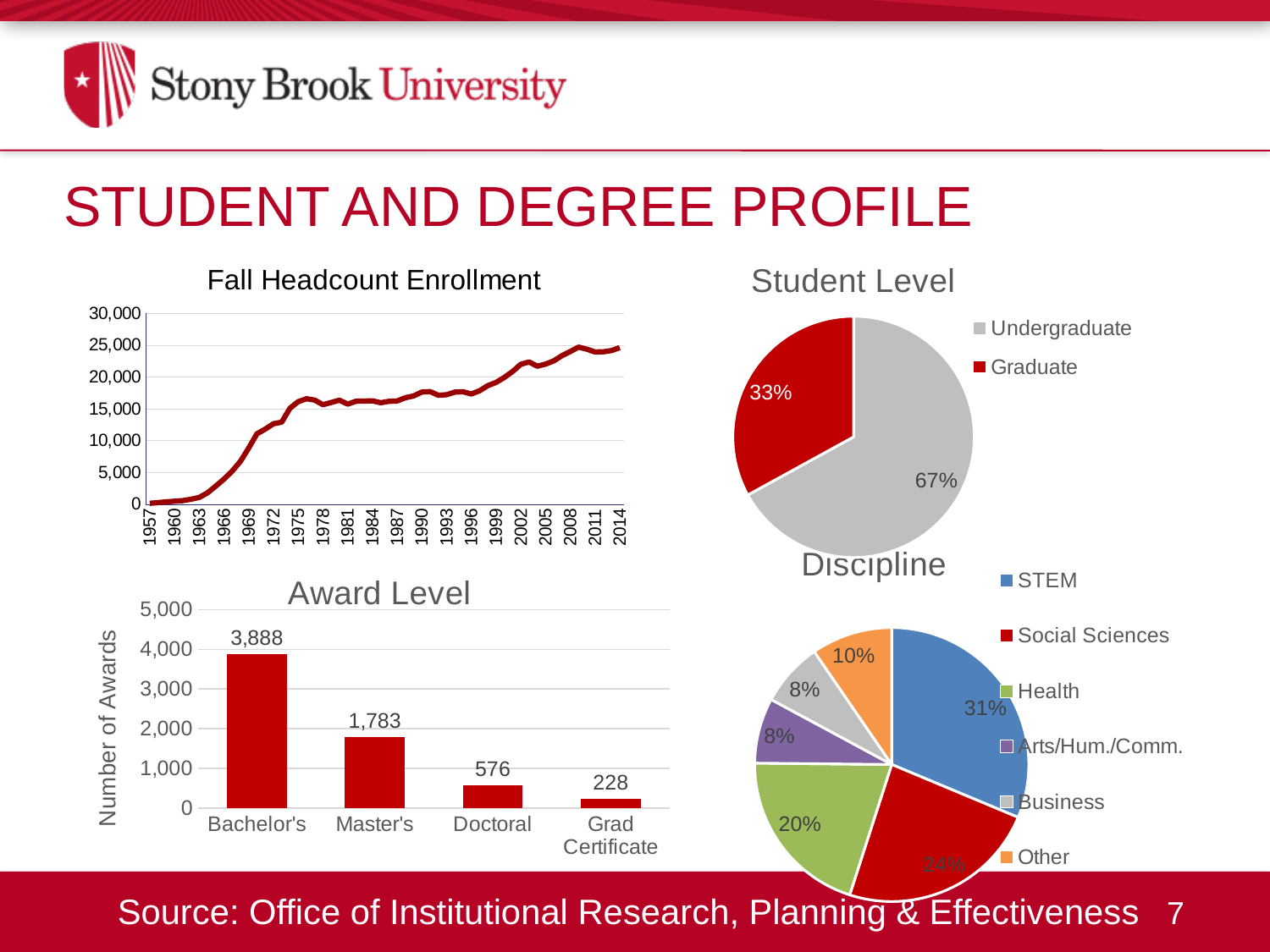
In the Award Level chart, what is the difference between the number of Bachelor's awards and Master's awards? 2,105 In the Award Level chart, which award level has the fewest awards? Grad Certificate In the Student Level pie chart, which category is the largest? Undergraduate In the Discipline pie chart, which discipline has the largest share? STEM In the Student Level pie chart, what share of students are Graduate? 33% In the Award Level chart, how many awards were at the Doctoral level? 576 In the Discipline pie chart, what share is Social Sciences? 24% In the Award Level chart, how many award levels are shown? 4 In the Award Level chart, how many awards were at the Bachelor's level? 3,888 In the Discipline pie chart, how many categories does the legend list? 6 In the Fall Headcount Enrollment chart, is the value for 2014 greater or less than 20,000? greater What kind of chart is the Award Level chart? Bar chart